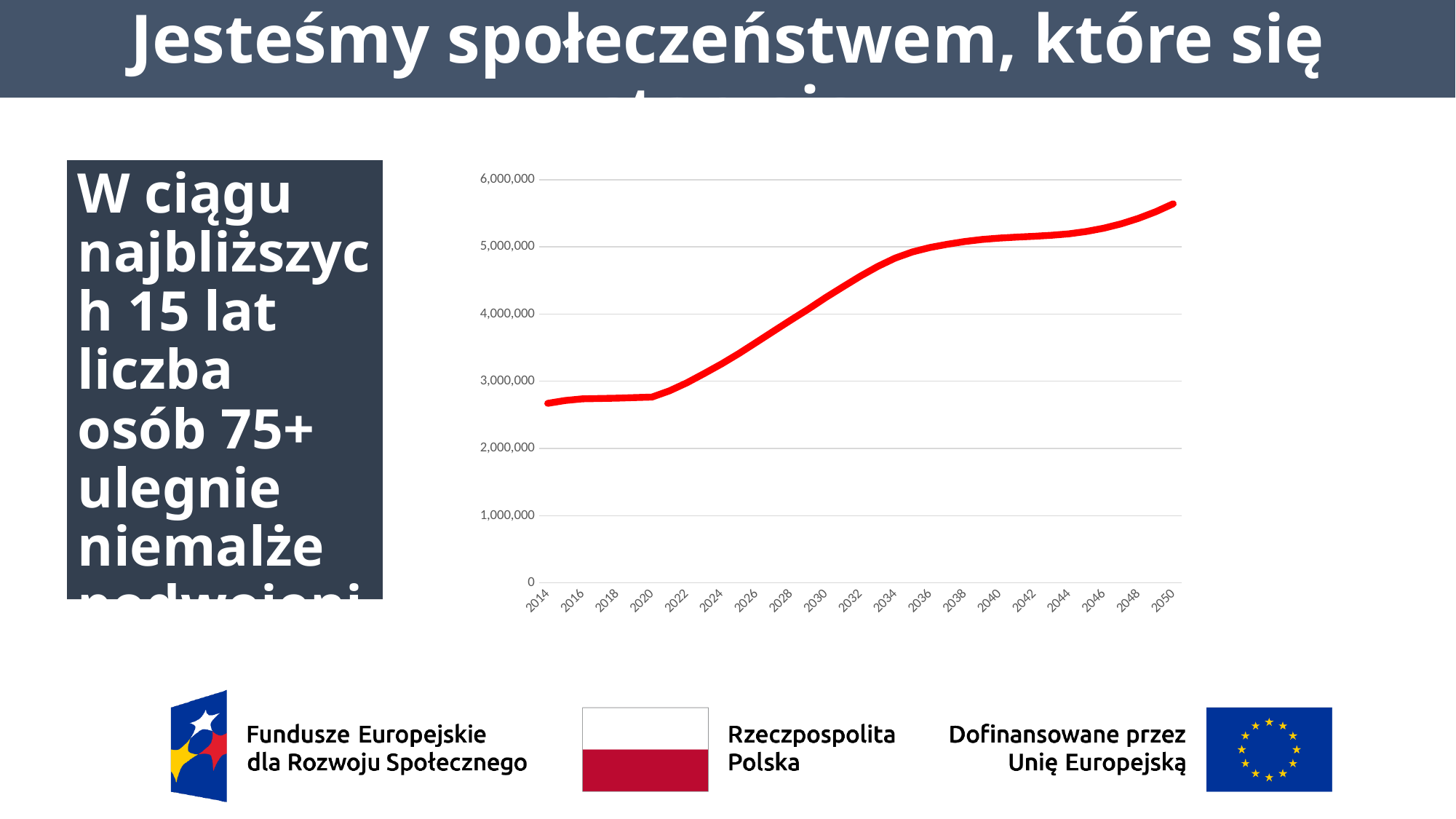
Is the value for 2050 greater or less than 5,000,000? greater Which is larger, the value for 2020 or the value for 2040? 2040 Is the value for 2014 greater or less than 3,000,000? less How many year labels are shown on the x axis? 19 Is the value for 2024 greater or less than 3,000,000? greater Which year on the x axis has the lowest value? 2014 What colour is the line on the chart? red Do the values on the chart generally rise or fall from 2014 to 2050? rise What kind of chart is shown on the slide? line chart Which year on the x axis has the highest value? 2050